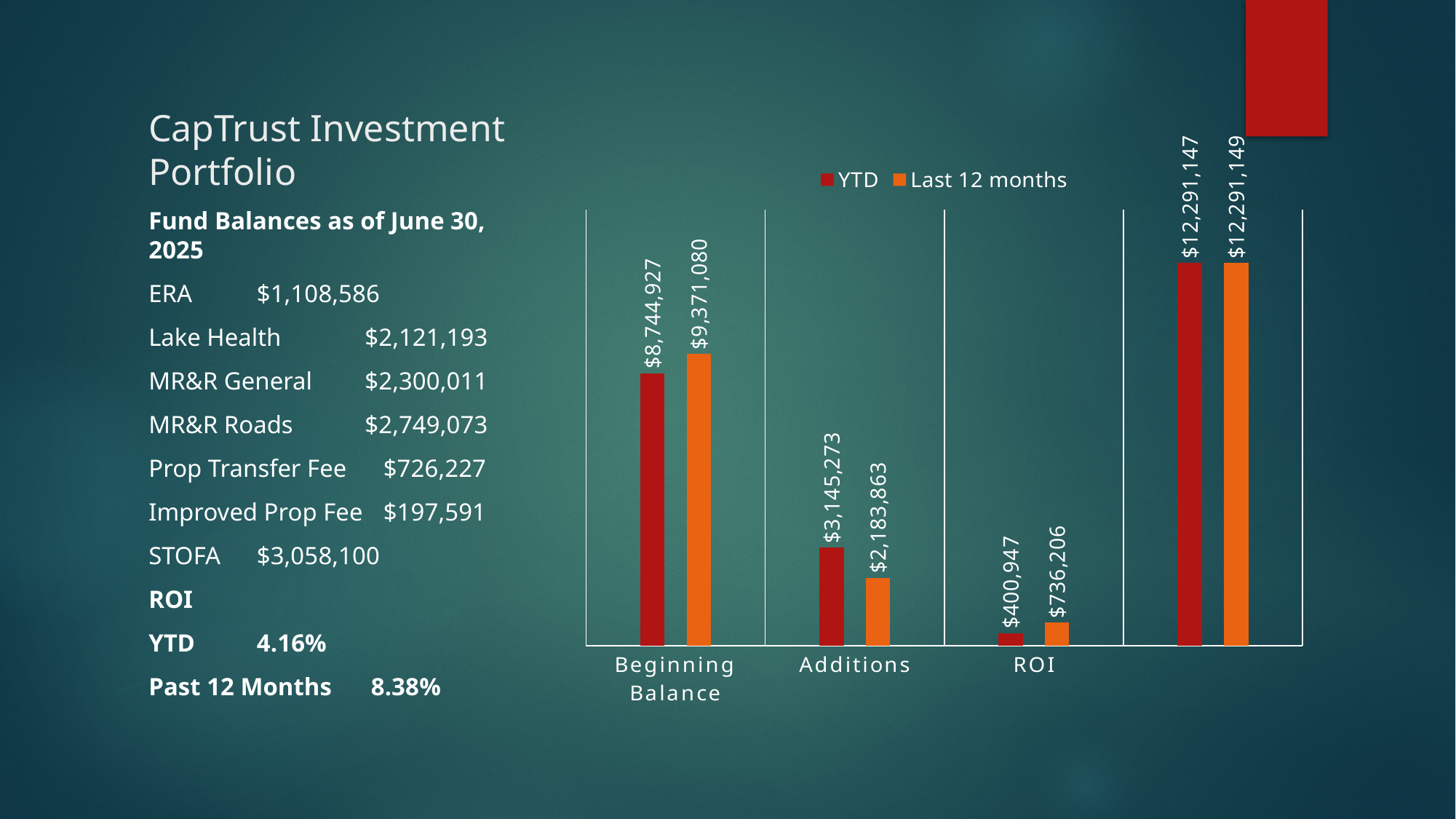
What is the difference between the YTD and Last 12 months values for Additions? $961,410 What kind of chart is shown on the slide? Bar chart What is the YTD value for Beginning Balance? $8,744,927 What is the Last 12 months value for Beginning Balance? $9,371,080 What is the Last 12 months value for Additions? $2,183,863 For Additions, which is larger: the YTD value or the Last 12 months value? YTD What is the YTD value for ROI? $400,947 Which category has the lowest YTD value? ROI How many series does the legend list? 2 For ROI, which is larger: the YTD value or the Last 12 months value? Last 12 months Which category has the lowest Last 12 months value? ROI What is the difference between the Last 12 months and YTD values for Beginning Balance? $626,153